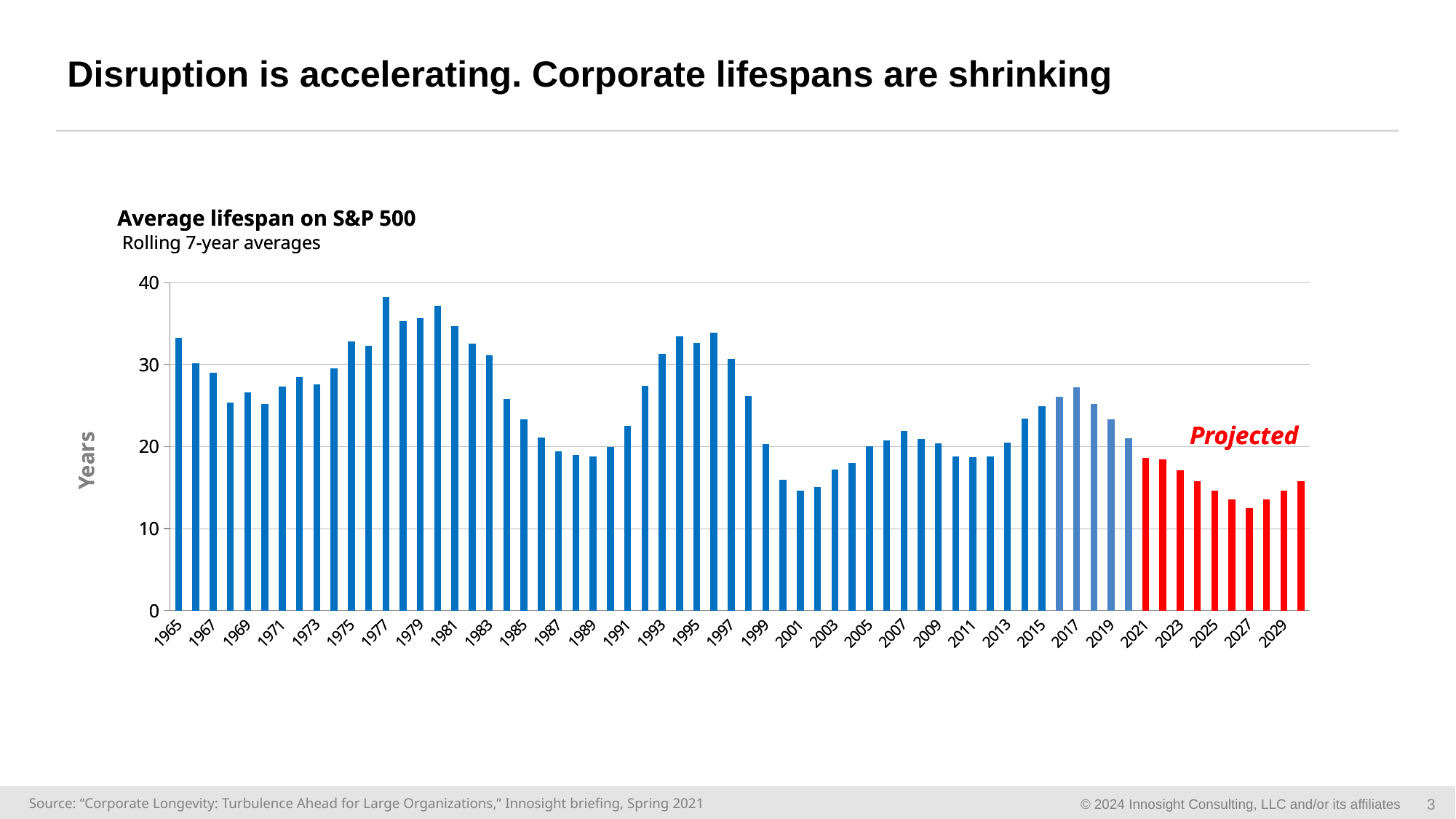
Do the values rise or fall from 2021 to 2027? fall Is the value for 1977 greater or less than 30? greater Is the value for 2001 greater or less than 20? less Which year has the lowest average lifespan? 2027 Is the value for 2027 greater or less than 20? less What label is given to the red bars at the right of the chart? Projected What kind of chart is shown on the slide? Bar chart Which is larger, the value for 1995 or the value for 2005? 1995 Which year has the highest average lifespan? 1977 What is the title of the chart? Average lifespan on S&P 500